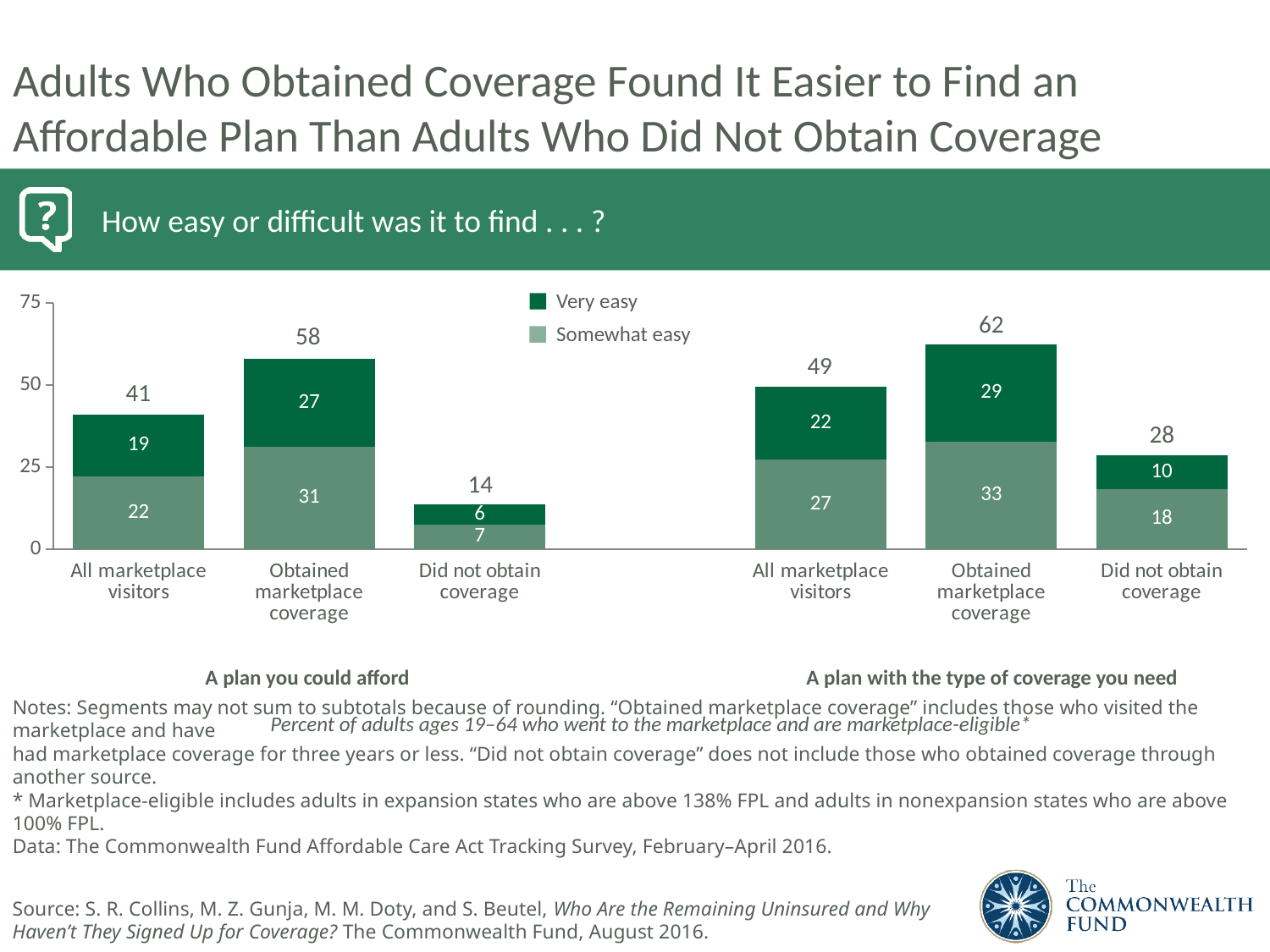
What is the 'Somewhat easy' value for 'All marketplace visitors' in the 'A plan you could afford' group? 22 Which category has the highest total in the 'A plan with the type of coverage you need' group? Obtained marketplace coverage What is the difference between the totals for 'Obtained marketplace coverage' and 'Did not obtain coverage' in the 'A plan with the type of coverage you need' group? 34 Which category has the lowest total in the 'A plan you could afford' group? Did not obtain coverage How many series does the legend list? 2 How many bars are plotted in the chart in total? 6 What kind of chart is shown on the slide? stacked bar chart Is the total for 'All marketplace visitors' in the 'A plan with the type of coverage you need' group greater or less than 25? greater Which is larger: the 'Very easy' value for 'Obtained marketplace coverage' in the 'A plan you could afford' group or in the 'A plan with the type of coverage you need' group? A plan with the type of coverage you need What is the 'Very easy' value for 'Did not obtain coverage' in the 'A plan with the type of coverage you need' group? 10 What is the total for 'Obtained marketplace coverage' in the 'A plan you could afford' group? 58 What is the 'Somewhat easy' value for 'Did not obtain coverage' in the 'A plan you could afford' group? 7